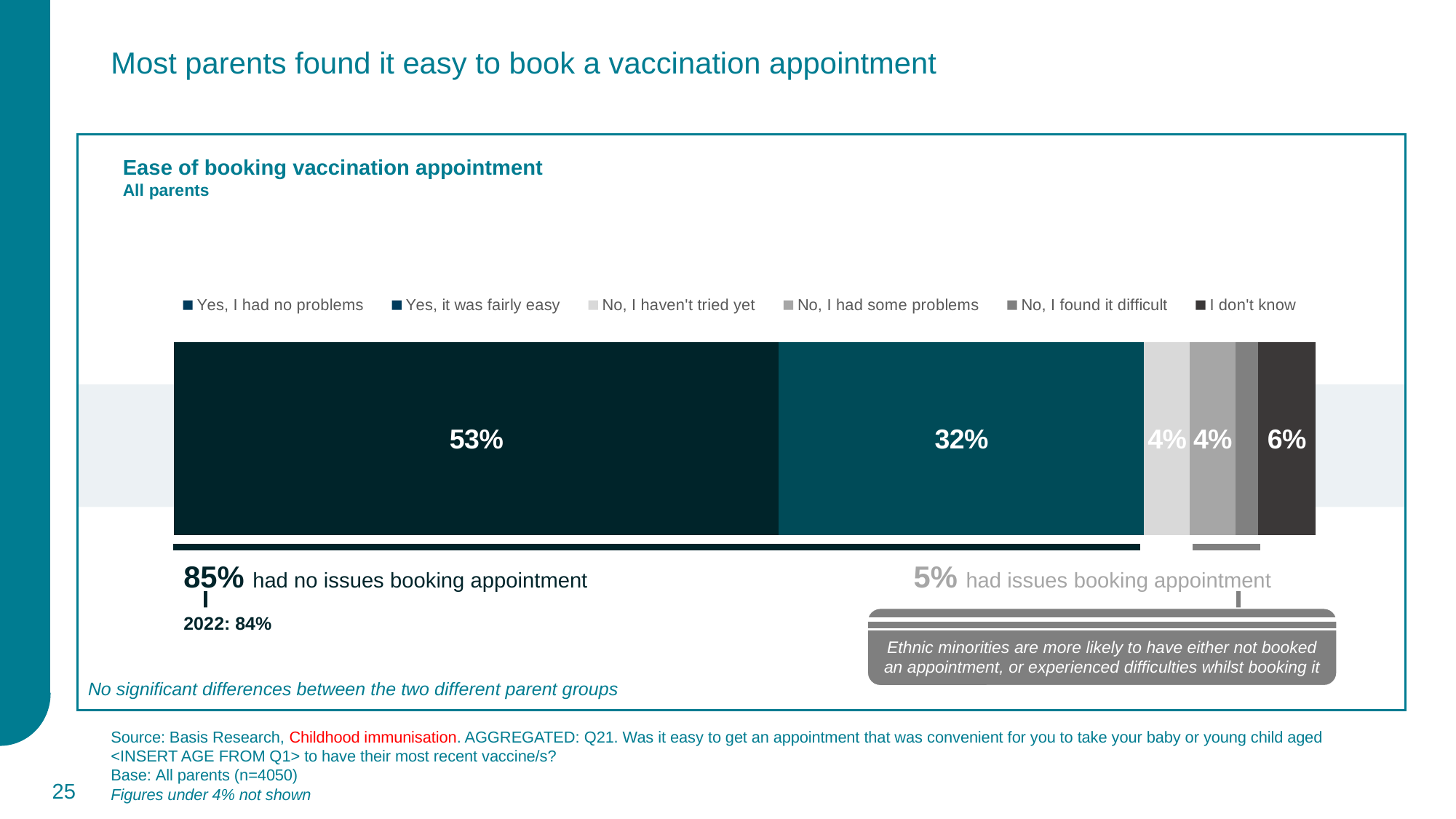
What percentage of parents said "No, I had some problems"? 4% What percentage of parents answered "I don't know"? 6% What percentage of parents said "Yes, it was fairly easy"? 32% Which response category has the largest share of the bar? Yes, I had no problems Which is larger: the share for "I don't know" or the share for "No, I had some problems"? I don't know What percentage of parents said "No, I haven't tried yet"? 4% What percentage of parents said "Yes, I had no problems" booking a vaccination appointment? 53% What is the title of the chart? Ease of booking vaccination appointment How many response categories does the legend list? 6 What is the difference in percentage points between "Yes, I had no problems" and "Yes, it was fairly easy"? 21 percentage points What type of chart is shown on the slide? Stacked bar chart Which group of respondents does the chart cover, according to its subtitle? All parents